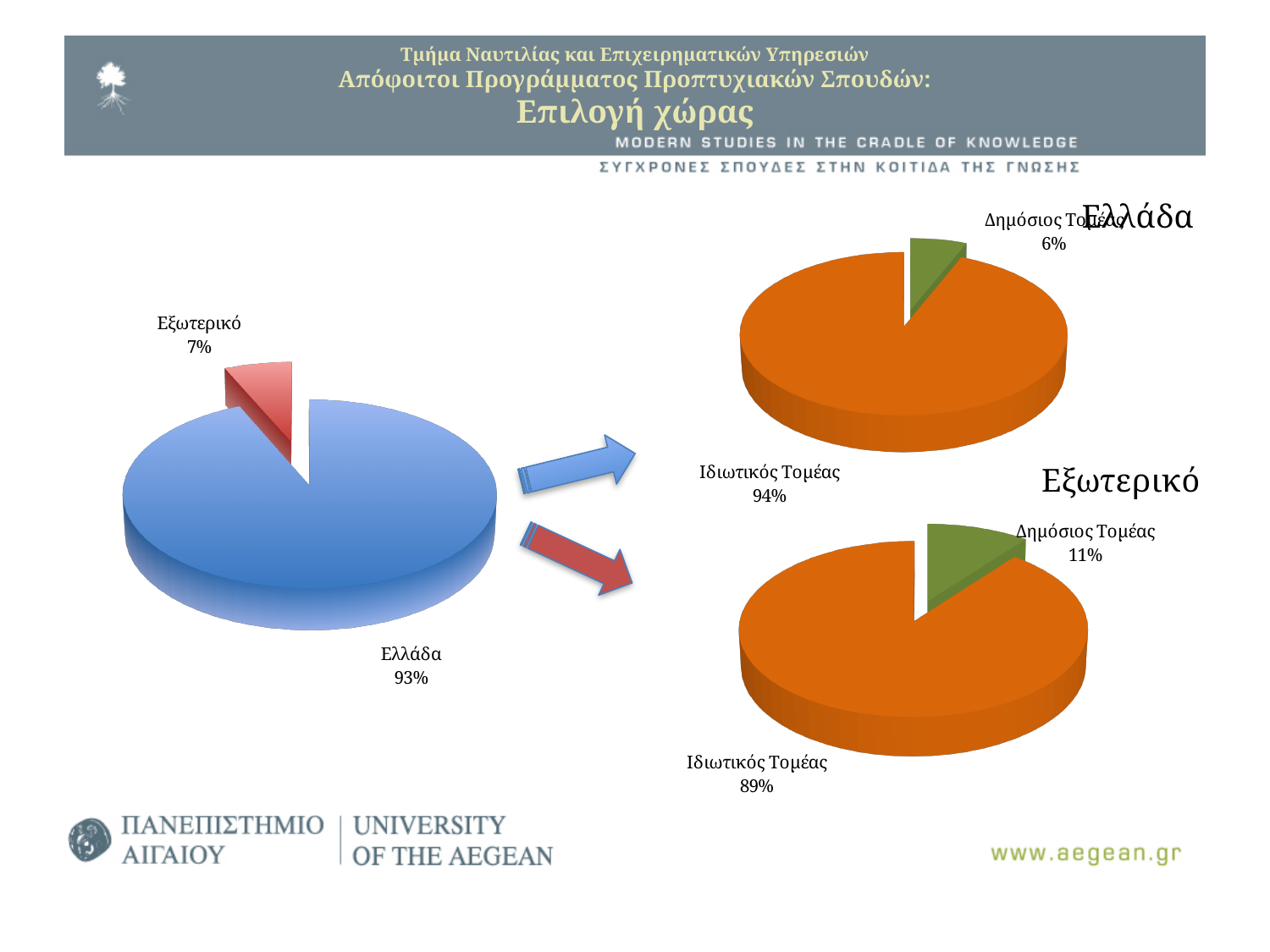
In the top-right pie chart titled Ελλάδα, which slice is the smallest? Δημόσιος Τομέας In the top-right pie chart titled Ελλάδα, what share is labelled for Ιδιωτικός Τομέας? 94% Which is larger: the Δημόσιος Τομέας share in the Ελλάδα pie chart or the Δημόσιος Τομέας share in the Εξωτερικό pie chart? Εξωτερικό (11%) In the bottom-right pie chart titled Εξωτερικό, what is the difference in percentage points between Ιδιωτικός Τομέας and Δημόσιος Τομέας? 78 percentage points In the pie chart on the left of the slide, what share is labelled for Ελλάδα? 93% In the pie chart on the left of the slide, how many slices are there? 2 In the bottom-right pie chart titled Εξωτερικό, what share is labelled for Ιδιωτικός Τομέας? 89% What kind of chart is the chart on the left of the slide? Pie chart In the pie chart on the left of the slide, what share is labelled for Εξωτερικό? 7% In the pie chart on the left of the slide, which slice is the largest? Ελλάδα In the top-right pie chart titled Ελλάδα, what share is labelled for Δημόσιος Τομέας? 6% In the bottom-right pie chart titled Εξωτερικό, what share is labelled for Δημόσιος Τομέας? 11%